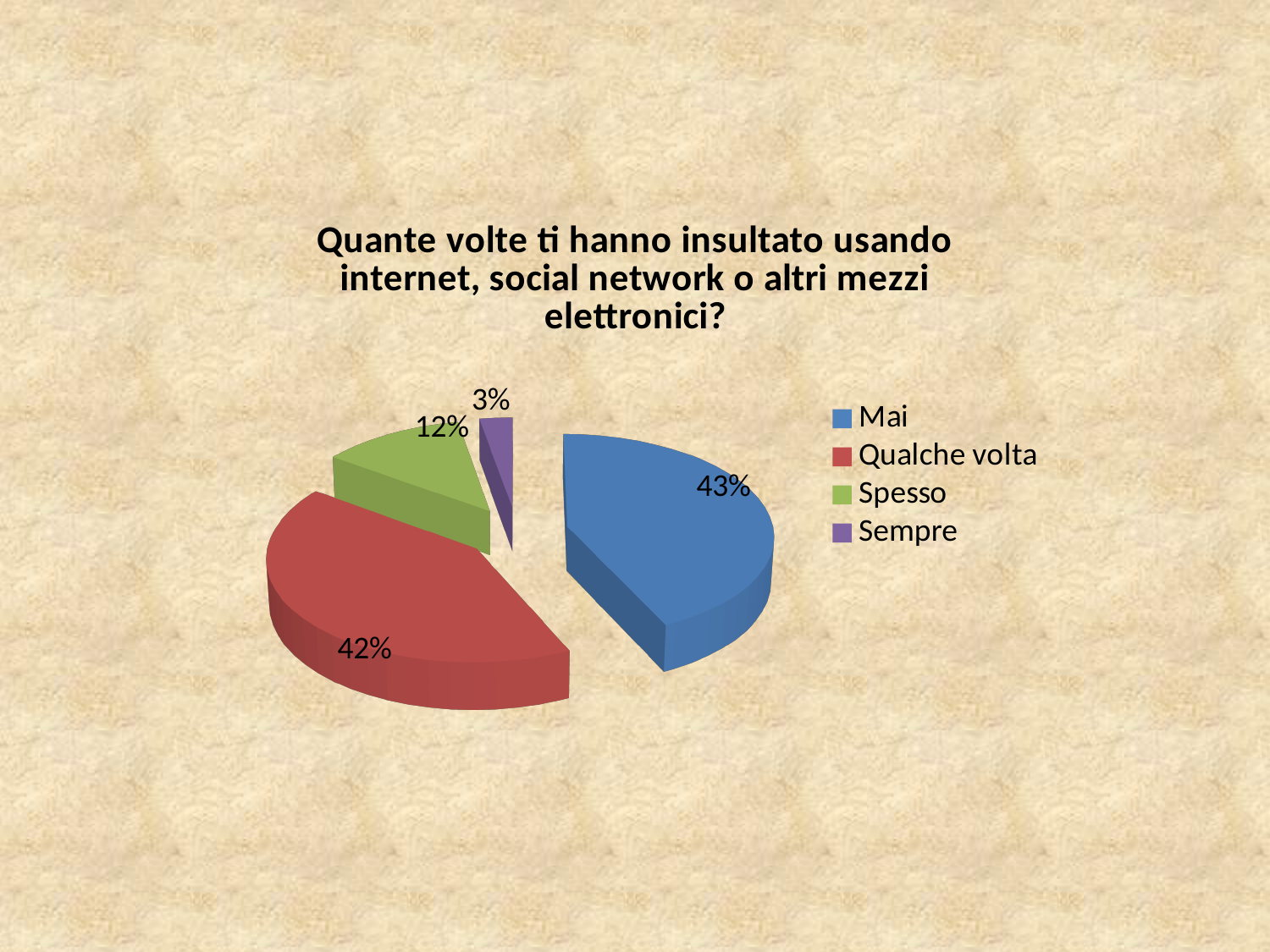
What kind of chart is shown on the slide? Pie chart Which is larger, the "Qualche volta" slice or the "Spesso" slice? Qualche volta Which category has the smallest slice of the pie? Sempre What percentage of the pie is labelled for "Spesso"? 12% What percentage of the pie is labelled for "Sempre"? 3% What percentage of the pie is labelled for "Qualche volta"? 42% How many slices does the pie chart have? 4 What percentage of the pie is labelled for "Mai"? 43% What colour is the "Qualche volta" slice in the pie chart? Red How many entries does the legend list? 4 What is the difference in percentage points between the "Spesso" slice and the "Sempre" slice? 9 What is the difference in percentage points between the "Mai" slice and the "Spesso" slice? 31